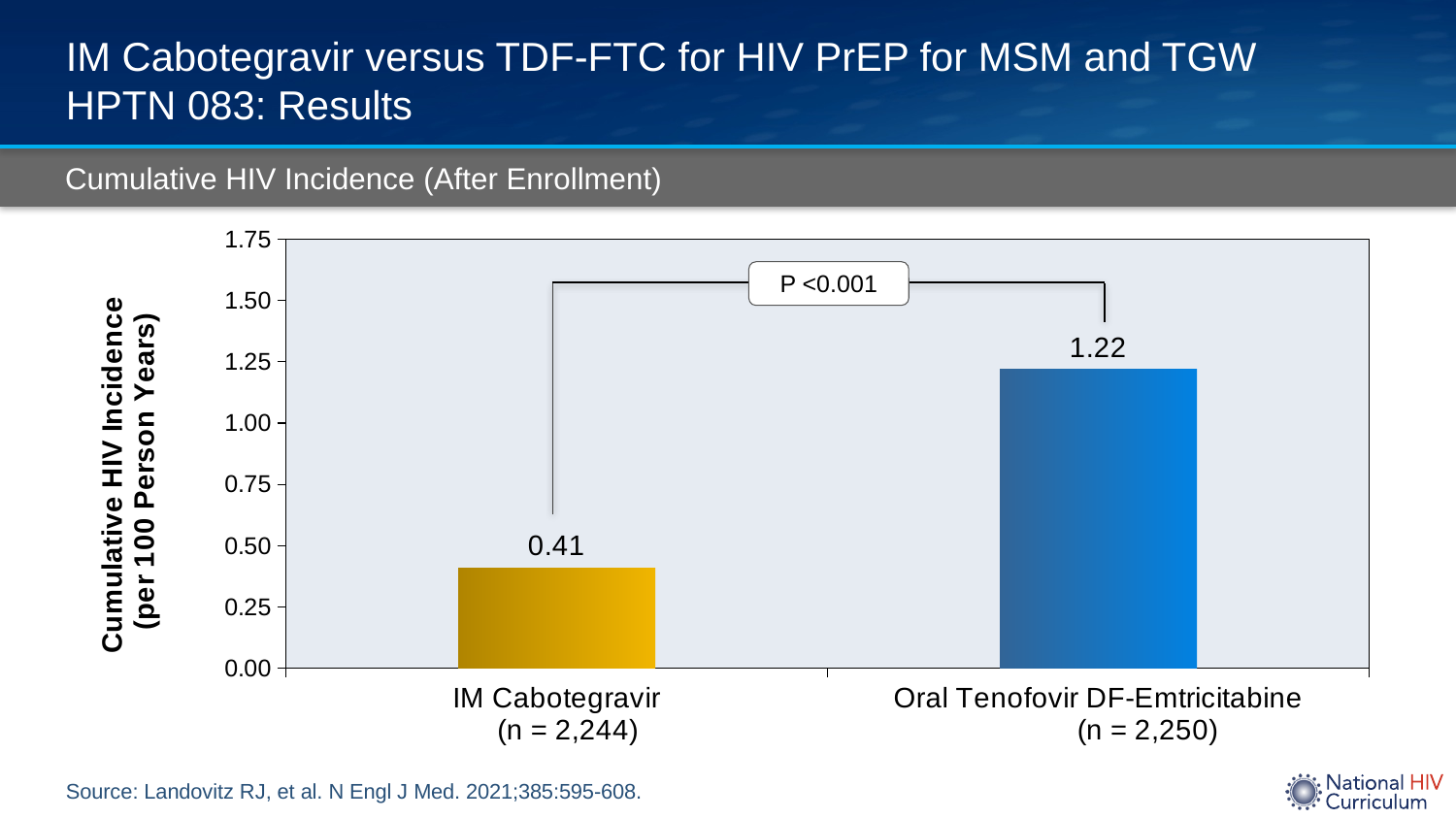
What kind of chart is shown on the slide? Bar chart Which group has the lower cumulative HIV incidence? IM Cabotegravir Is the cumulative HIV incidence for Oral Tenofovir DF-Emtricitabine greater or less than 1.00? greater What is the cumulative HIV incidence for Oral Tenofovir DF-Emtricitabine? 1.22 How many groups are shown in the chart? 2 What is the title of the chart? Cumulative HIV Incidence (After Enrollment) How many participants were in the IM Cabotegravir group? 2,244 What is the cumulative HIV incidence for IM Cabotegravir? 0.41 What is the P value shown in the chart? P <0.001 Which group has the higher cumulative HIV incidence? Oral Tenofovir DF-Emtricitabine Is the cumulative HIV incidence for IM Cabotegravir greater or less than 0.50? less What is the difference in cumulative HIV incidence between Oral Tenofovir DF-Emtricitabine and IM Cabotegravir? 0.81